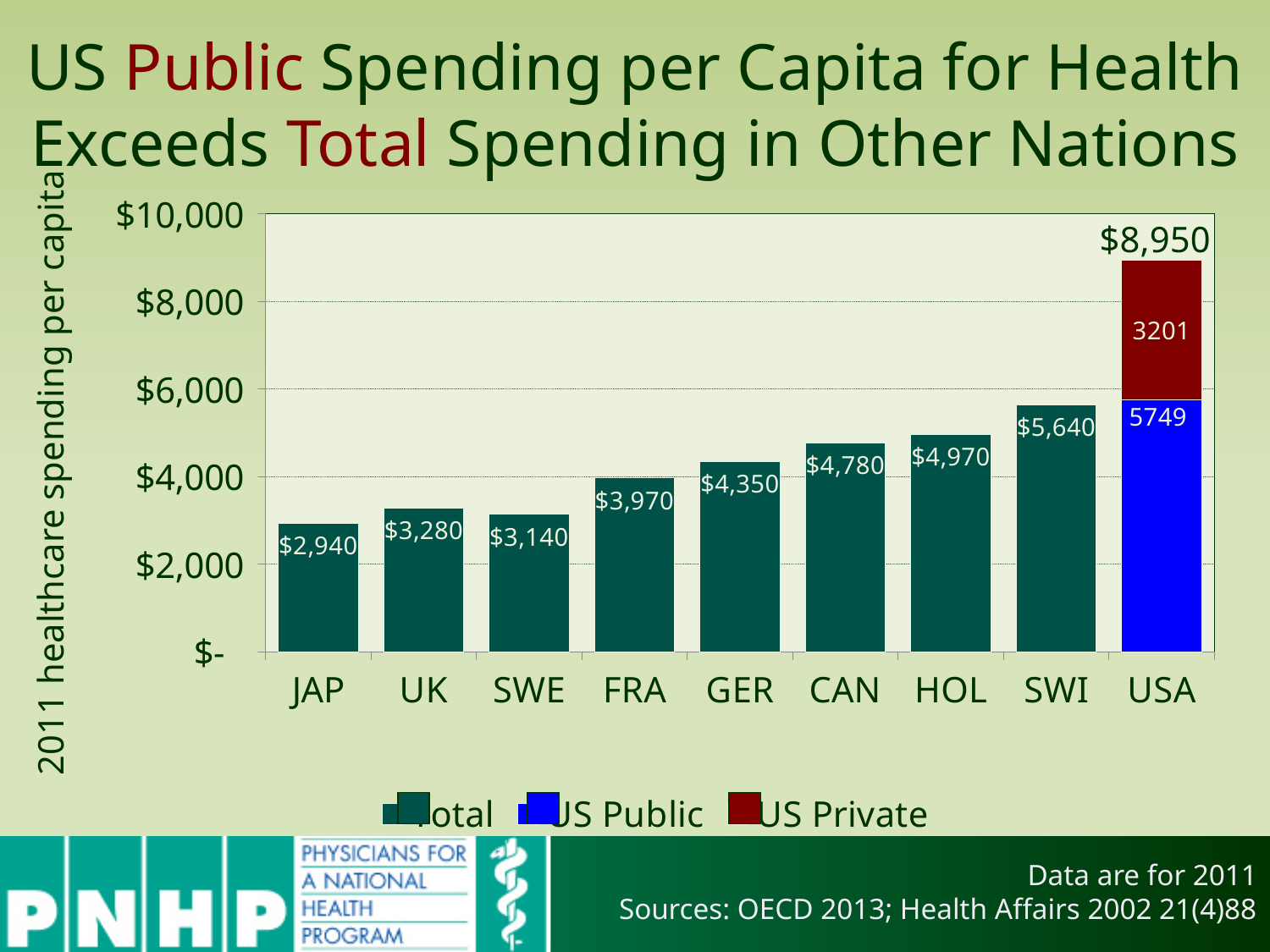
What is the total healthcare spending per capita for Japan (JAP)? $2,940 What is the difference between Switzerland's (SWI) and Canada's (CAN) spending per capita? $860 What is the US Public spending per capita shown on the USA bar? 5749 What is the total spending per capita labelled above the USA bar? $8,950 Is the value for GER greater or less than $4,000? greater What is the US Private spending per capita shown on the USA bar? 3201 Which country has the highest healthcare spending per capita? USA Which country has the lowest healthcare spending per capita? JAP What kind of chart is shown on the slide? Bar chart How many series does the legend list? 3 Which has higher spending per capita, UK or SWE? UK How many countries are shown on the x axis? 9